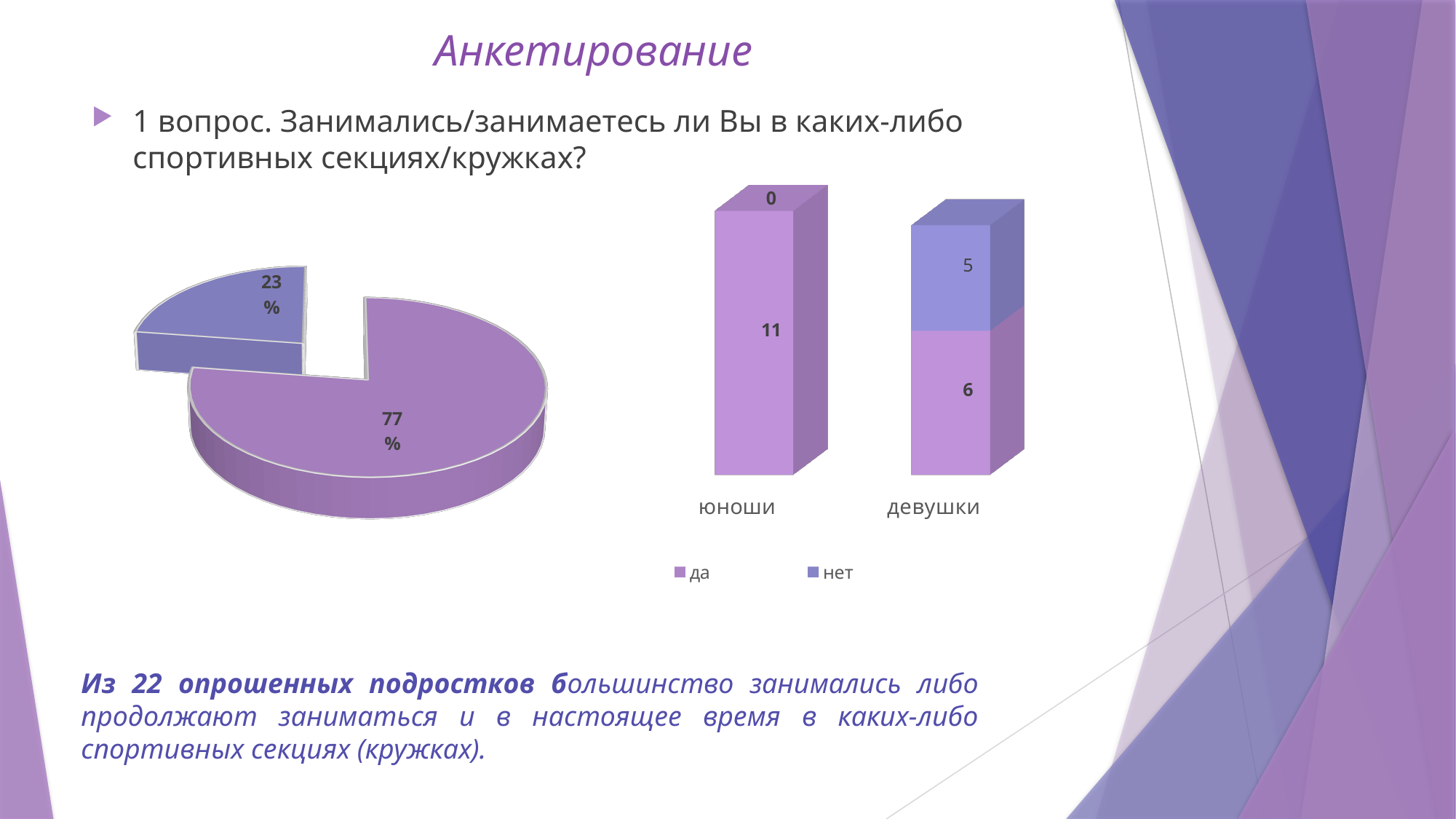
What kind of chart is the chart on the left of the slide? pie chart In the pie chart on the left, how many slices are there? 2 What kind of chart is the chart on the right of the slide? bar chart In the bar chart on the right, how many series does the legend list? 2 In the bar chart on the right, what is the difference between the 'да' values for юноши and девушки? 5 In the bar chart on the right, what is the value of 'да' for девушки? 6 In the bar chart on the right, what is the total of the stacked bar for девушки? 11 In the pie chart on the left, what is the value of the larger slice? 77% In the pie chart on the left, what is the value of the smaller slice? 23% In the bar chart on the right, what is the value of 'нет' for юноши? 0 In the bar chart on the right, what is the value of 'нет' for девушки? 5 In the bar chart on the right, what is the value of 'да' for юноши? 11